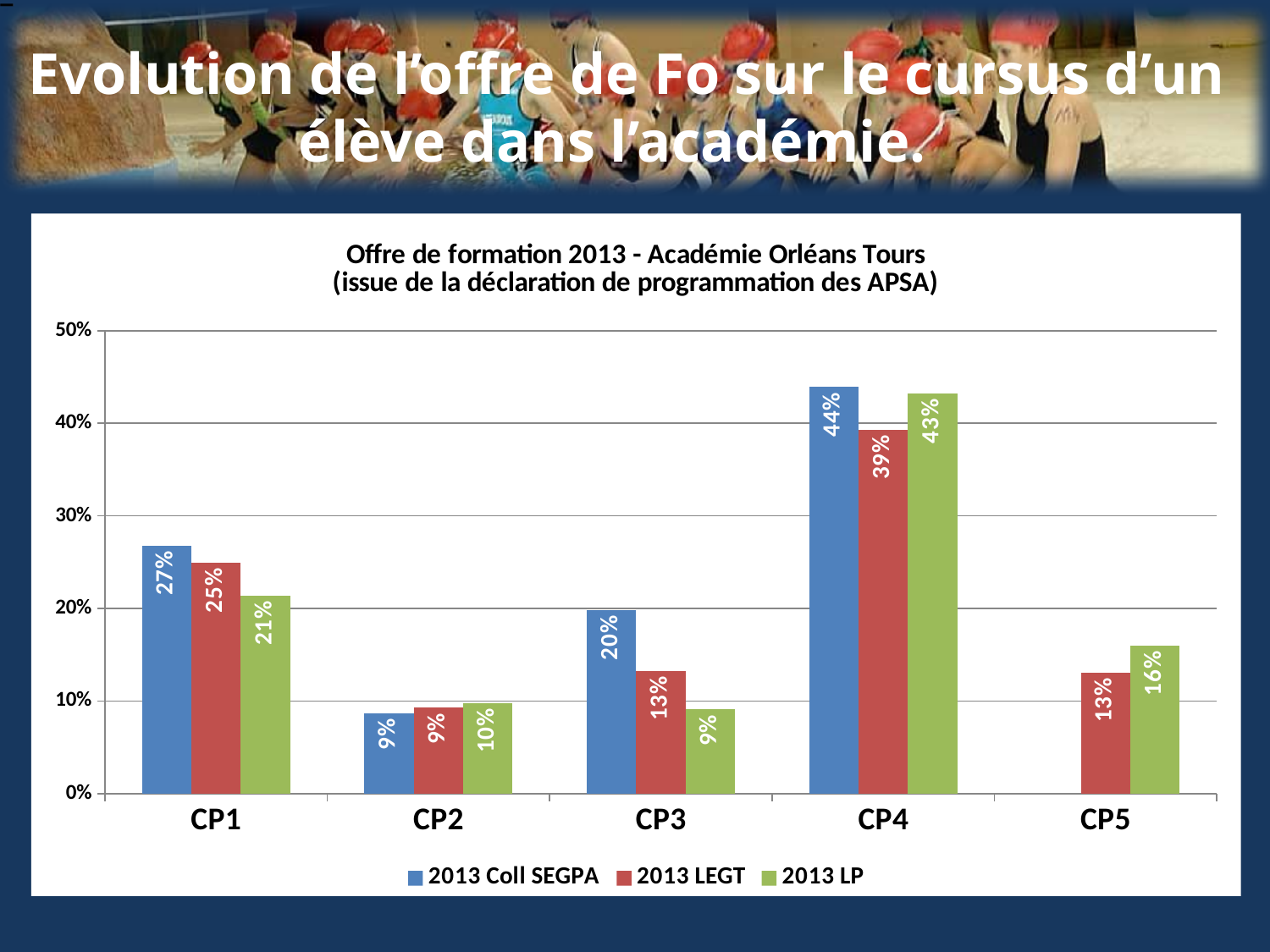
How many categories are shown on the x axis? 5 Which category has the lowest value for the 2013 LP series? CP3 Which series has no bar in the CP5 category? 2013 Coll SEGPA What is the value for 2013 Coll SEGPA in CP4? 44% What is the value for 2013 LP in CP5? 16% Is the value for 2013 LP in CP4 greater or less than 40%? greater How many series does the legend list? 3 What is the difference between the 2013 Coll SEGPA and 2013 LEGT values in CP3? 7% What kind of chart is shown on the slide? Bar chart Which category has the highest value for the 2013 LEGT series? CP4 Which is larger in CP1: the 2013 Coll SEGPA value or the 2013 LP value? 2013 Coll SEGPA What is the value for 2013 LEGT in CP3? 13%